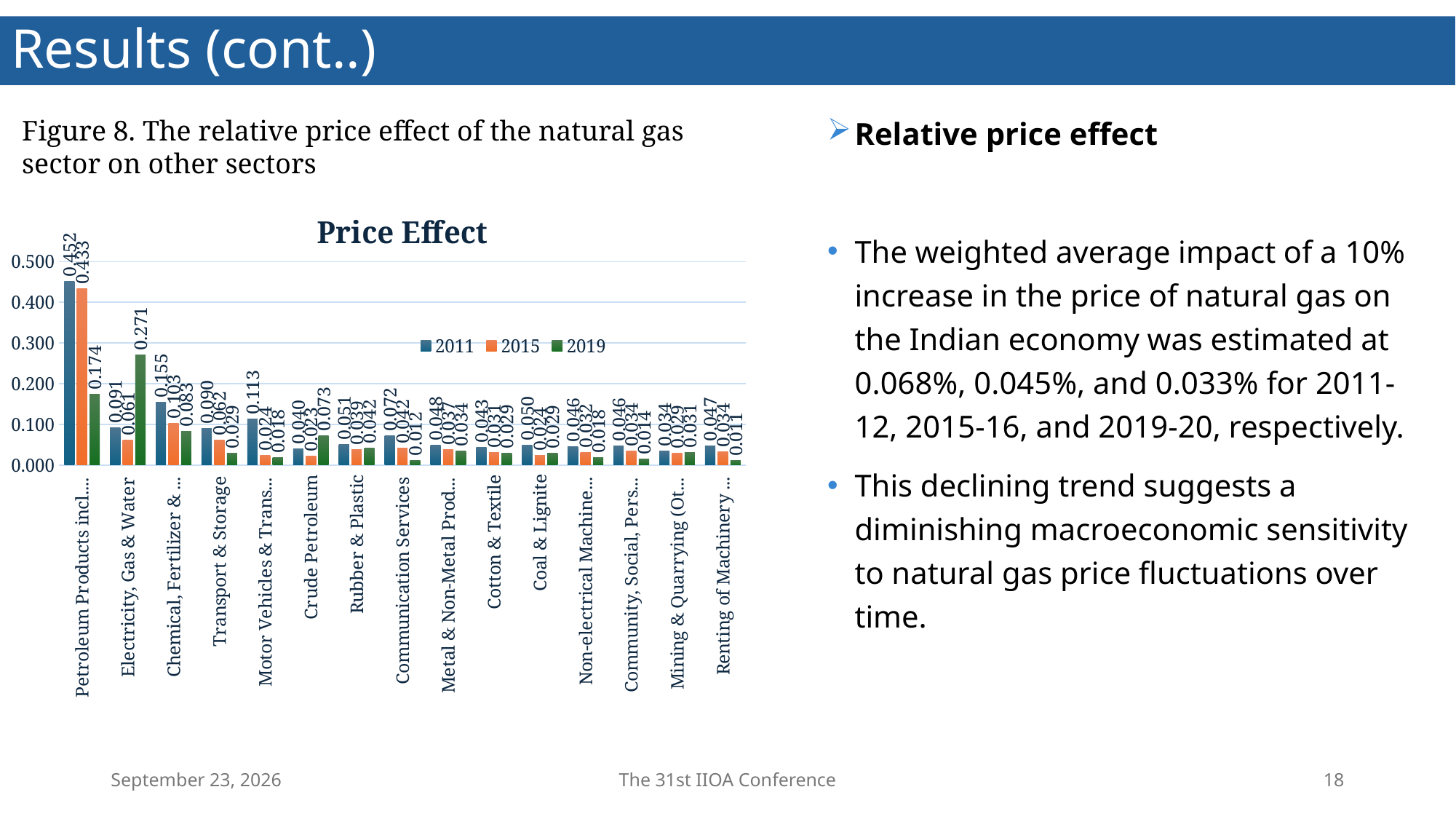
How many sectors are shown on the x axis? 15 What type of chart is shown on the slide? bar chart What is the 2019 value for Electricity, Gas & Water? 0.271 Which year has the highest value for Crude Petroleum? 2019 Is the 2011 value for Rubber & Plastic larger or smaller than the 2011 value for Cotton & Textile? larger What is the difference between the 2011 and 2019 values for Electricity, Gas & Water? 0.180 What is the 2015 value for Crude Petroleum? 0.023 Which year has the lowest value for Coal & Lignite? 2015 How many series does the legend list? 3 What is the title of the chart? Price Effect What is the 2011 value for Transport & Storage? 0.090 What is the 2019 value for Communication Services? 0.012